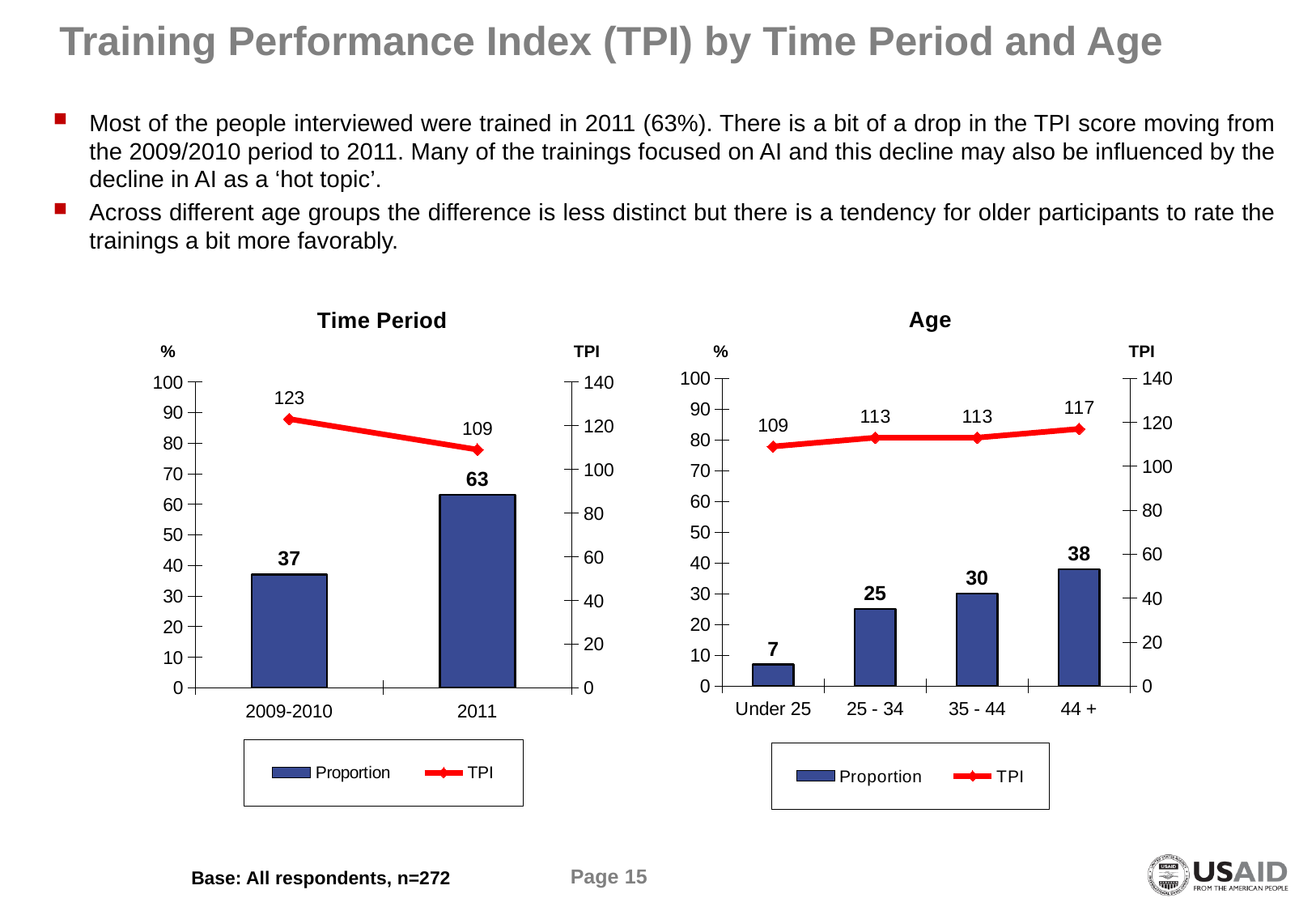
In the Time Period chart, what is the difference in TPI between 2009-2010 and 2011? 14 In the Age chart, what is the Proportion for Under 25? 7 In the Age chart, what is the TPI for 44 +? 117 In the Age chart, how many series does the legend list? 2 In the Time Period chart, what is the Proportion for 2011? 63 In the Age chart, what is the difference in Proportion between 44 + and 25 - 34? 13 In the Time Period chart, what is the TPI for 2009-2010? 123 In the Age chart, which age group has the highest Proportion? 44 + In the Time Period chart, what colour is the TPI line? Red In the Age chart, which age group has the lowest TPI? Under 25 In the Age chart, how many age groups are shown on the x axis? 4 In the Time Period chart, does the TPI rise or fall from 2009-2010 to 2011? fall